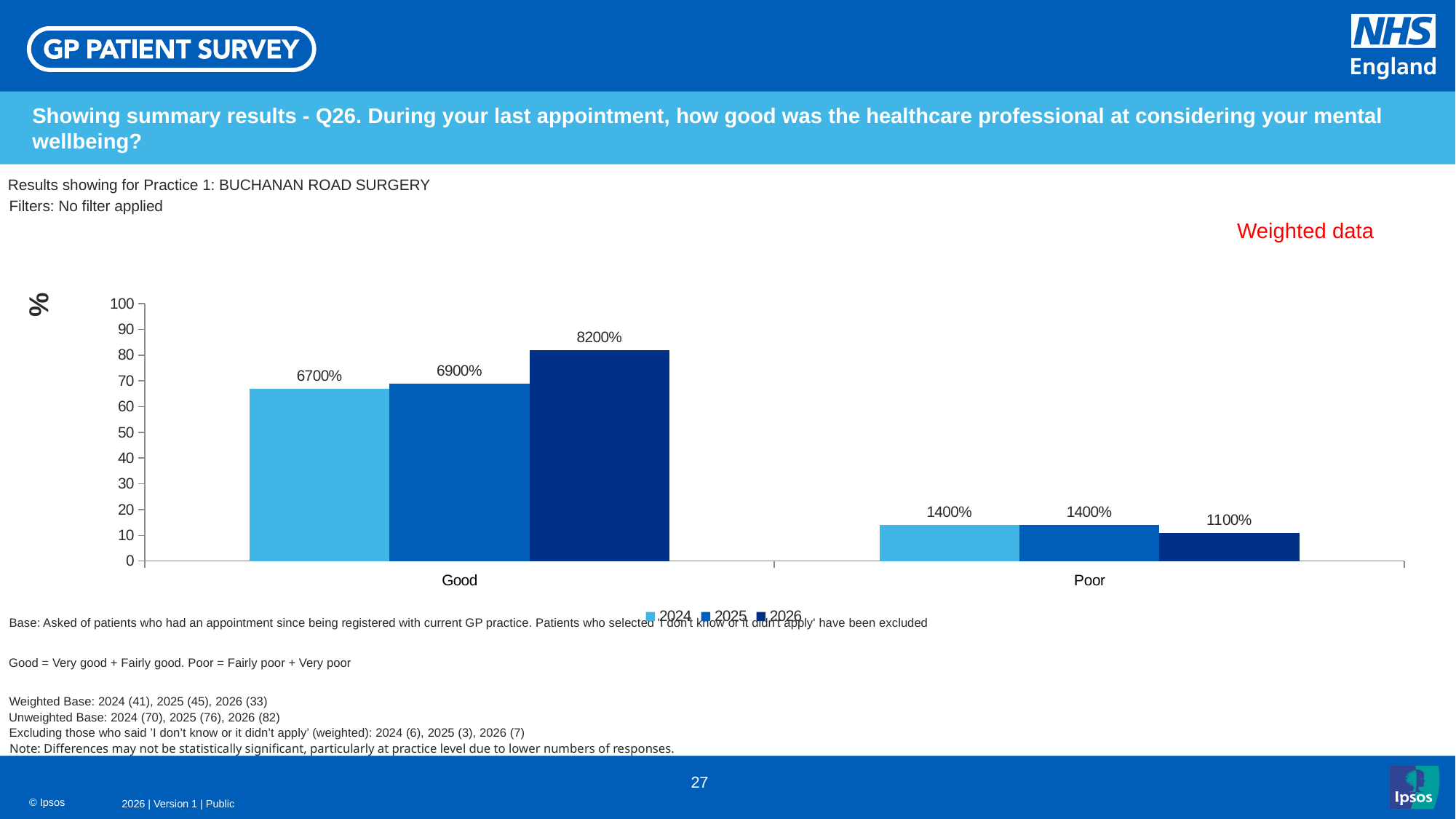
How many series does the legend list? 3 What is the data label shown for the 2026 series in the Good category? 8200% What is the data label shown for the 2026 series in the Poor category? 1100% How many categories are shown on the x axis? 2 Which year has the highest bar in the Good category? 2026 Is the 2024 bar for Poor greater or less than 20 on the axis? less What is the data label shown for the 2024 series in the Good category? 6700% What is the data label shown for the 2025 series in the Poor category? 1400% Is the 2026 bar for Good greater or less than 80 on the axis? greater Is the 2025 bar for Good larger or smaller than the 2025 bar for Poor? larger Which year has the lowest bar in the Poor category? 2026 What kind of chart is shown on the slide? bar chart